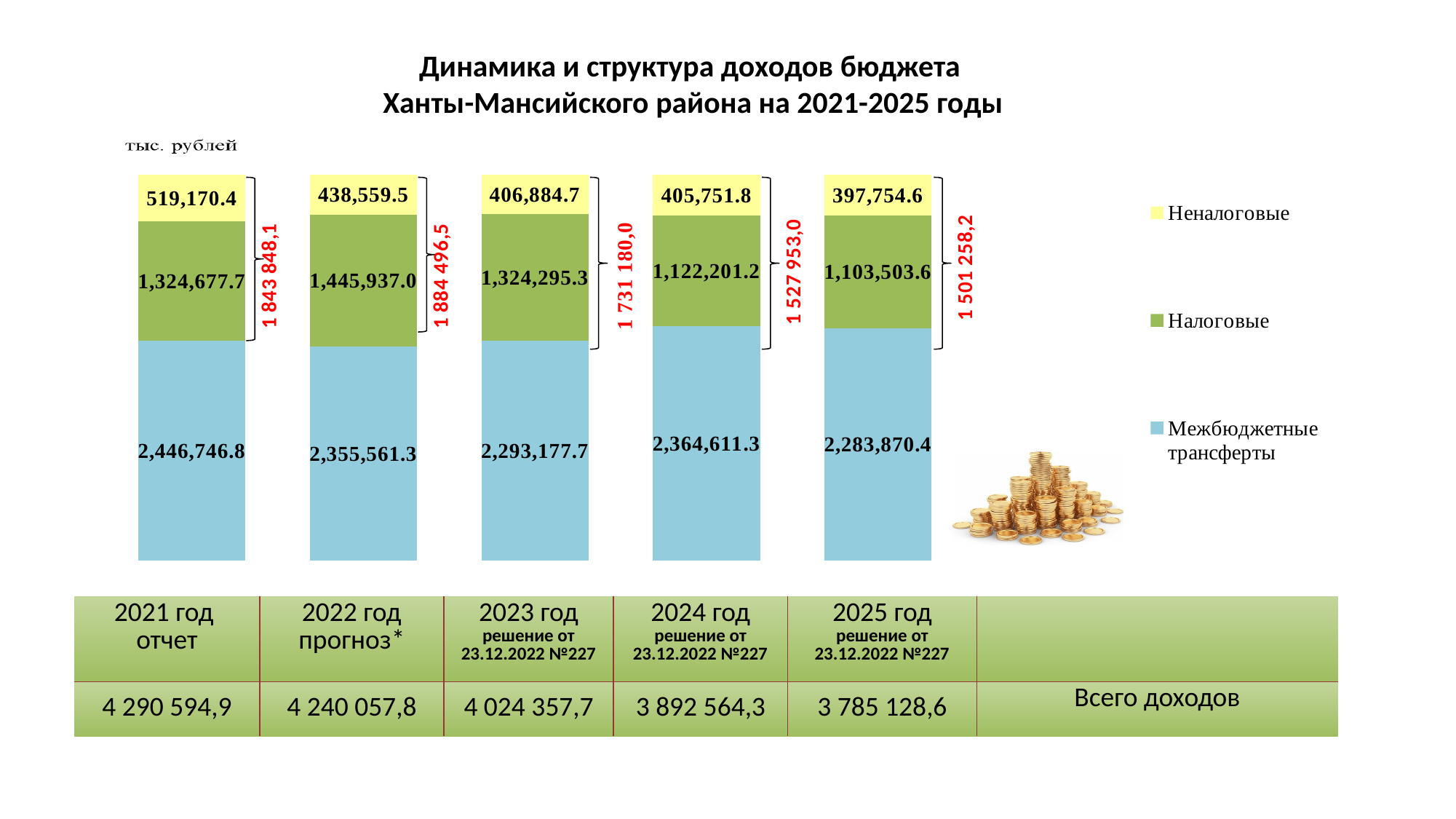
What is the difference between the Неналоговые values for 2021 and 2022? 80,610.9 In which year is the Неналоговые value the lowest? 2025 What is the value of Налоговые for 2022? 1,445,937.0 How many years (bars) are shown in the chart? 5 Which year has the larger Межбюджетные трансферты value, 2023 or 2024? 2024 Do the Неналоговые values rise or fall from 2021 to 2025? Fall What kind of chart is shown on the slide? Stacked bar chart What is the value of Неналоговые for 2021? 519,170.4 In which year is the Налоговые value the highest? 2022 What is the total of the 2021 stacked bar (all three series combined)? 4 290 594,9 What is the value of Межбюджетные трансферты for 2025? 2,283,870.4 How many series does the legend list? 3